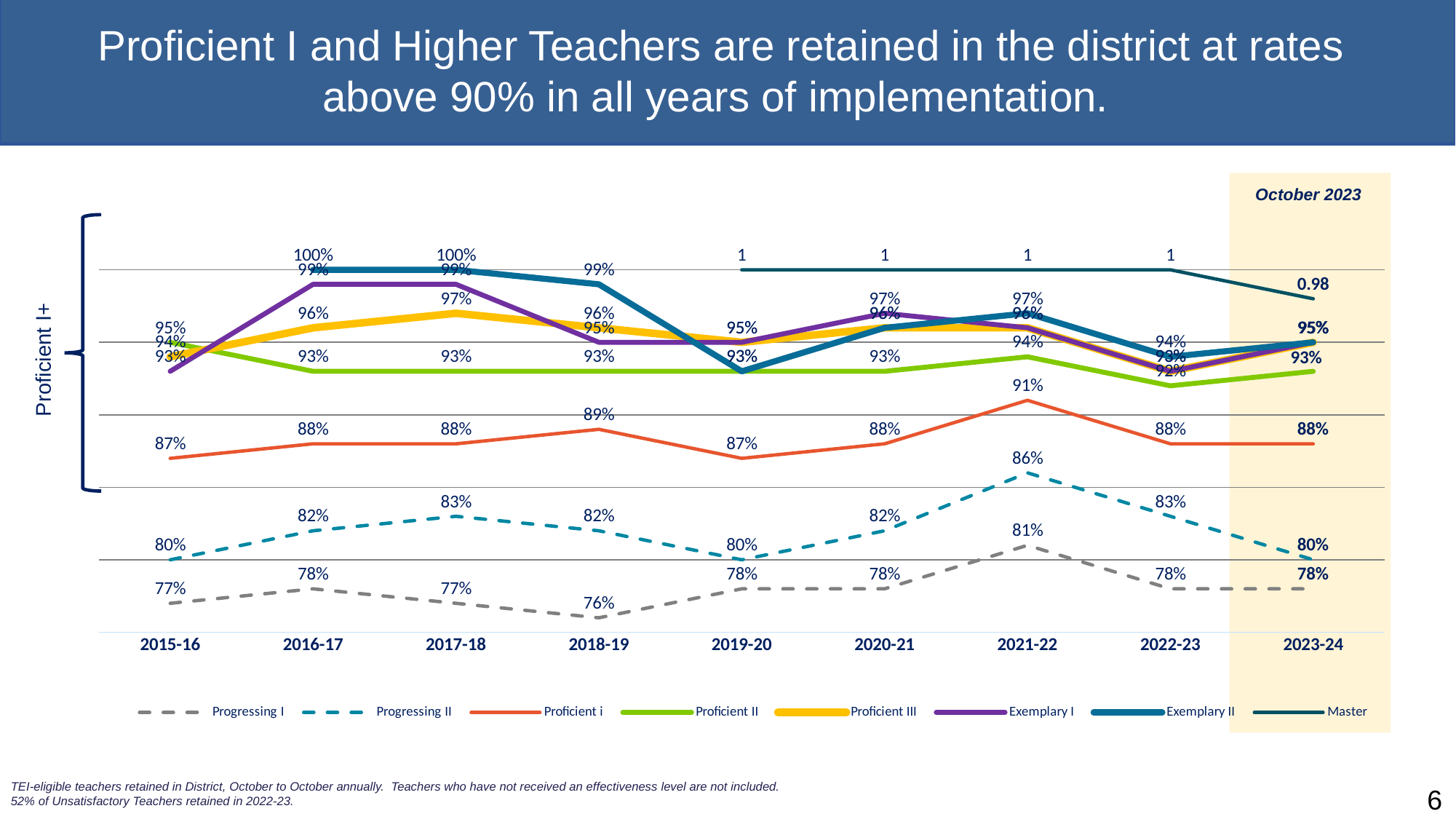
What is the retention rate for Progressing I teachers in 2018-19? 76% What label appears above the highlighted 2023-24 column? October 2023 What is the retention rate for Progressing II teachers in 2021-22? 86% What value is shown for the Master series in 2023-24? 0.98 What is the retention rate for Proficient i teachers in 2021-22? 91% Which year has the higher Proficient i retention rate, 2018-19 or 2019-20? 2018-19 By how many percentage points did the Progressing II retention rate fall from 2021-22 to 2022-23? 3 percentage points How many school years are shown along the x axis? 9 How many series does the legend list? 8 In which year is the Progressing I retention rate lowest? 2018-19 What type of chart is shown on the slide? Line chart In which year is the Progressing I retention rate highest? 2021-22